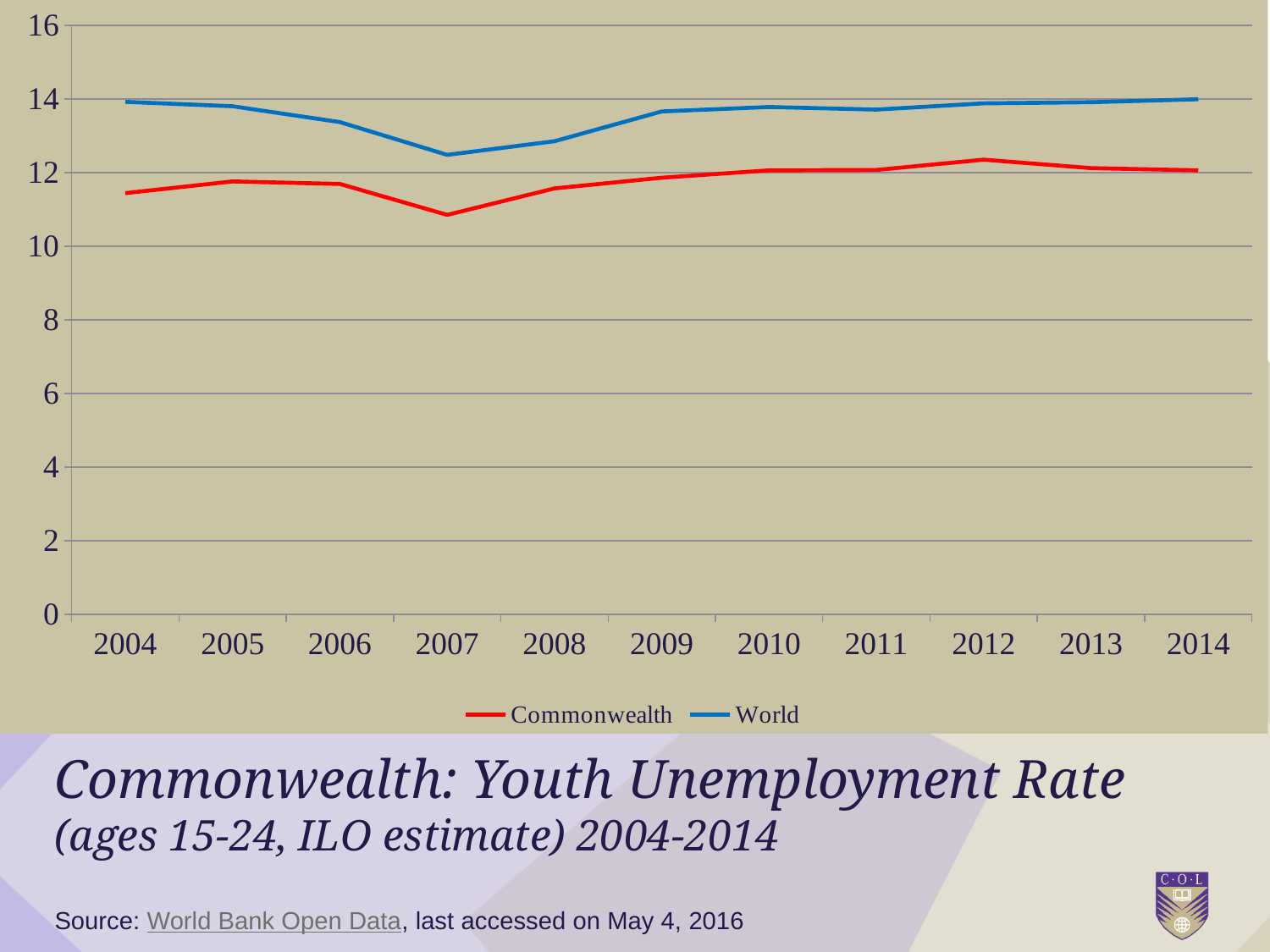
In which year is the Commonwealth youth unemployment rate highest? 2012 Does the Commonwealth line rise or fall between 2007 and 2012? rise In which year is the Commonwealth youth unemployment rate lowest? 2007 How many years are plotted along the x axis? 11 Is the World value for 2007 greater or less than 12? greater What colour is the line for the World series? blue How many series does the legend list? 2 Is the Commonwealth value for 2007 greater or less than 12? less In 2010, which series has the higher value, Commonwealth or World? World Is the Commonwealth value for 2004 greater or less than 10? greater What kind of chart is shown on the slide? line chart In which year is the World youth unemployment rate lowest? 2007